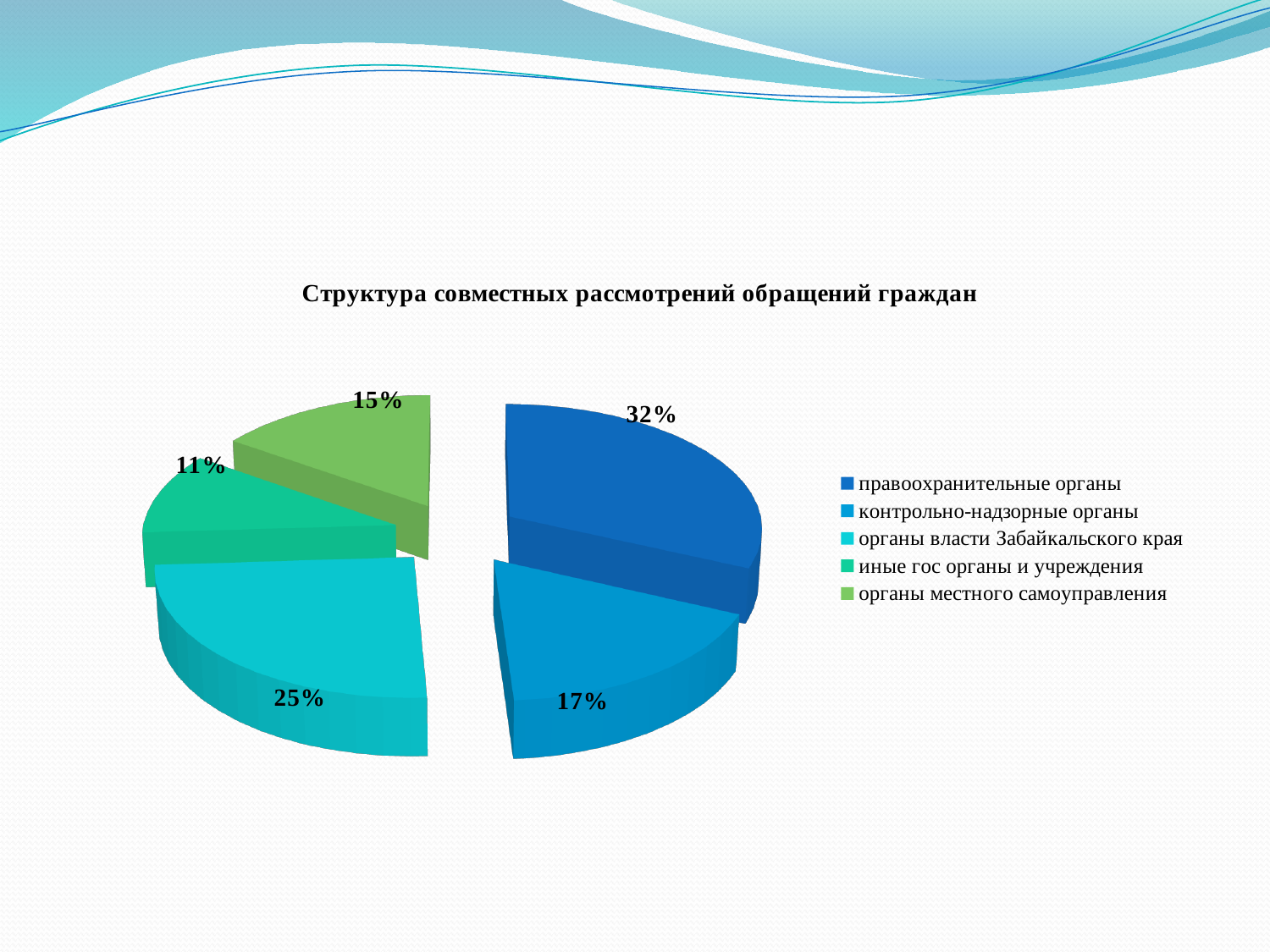
What share of the pie is labelled for контрольно-надзорные органы? 17% How many categories does the legend list? 5 What share of the pie is labelled for органы местного самоуправления? 15% Which is larger: the slice for органы власти Забайкальского края or the slice for органы местного самоуправления? органы власти Забайкальского края What share of the pie is labelled for органы власти Забайкальского края? 25% What share of the pie is labelled for правоохранительные органы? 32% What is the title of the chart? Структура совместных рассмотрений обращений граждан What type of chart is shown on the slide? pie chart Which category has the smallest slice of the pie? иные гос органы и учреждения Which category has the largest slice of the pie? правоохранительные органы What share of the pie is labelled for иные гос органы и учреждения? 11% What is the difference in percentage points between правоохранительные органы and контрольно-надзорные органы? 15